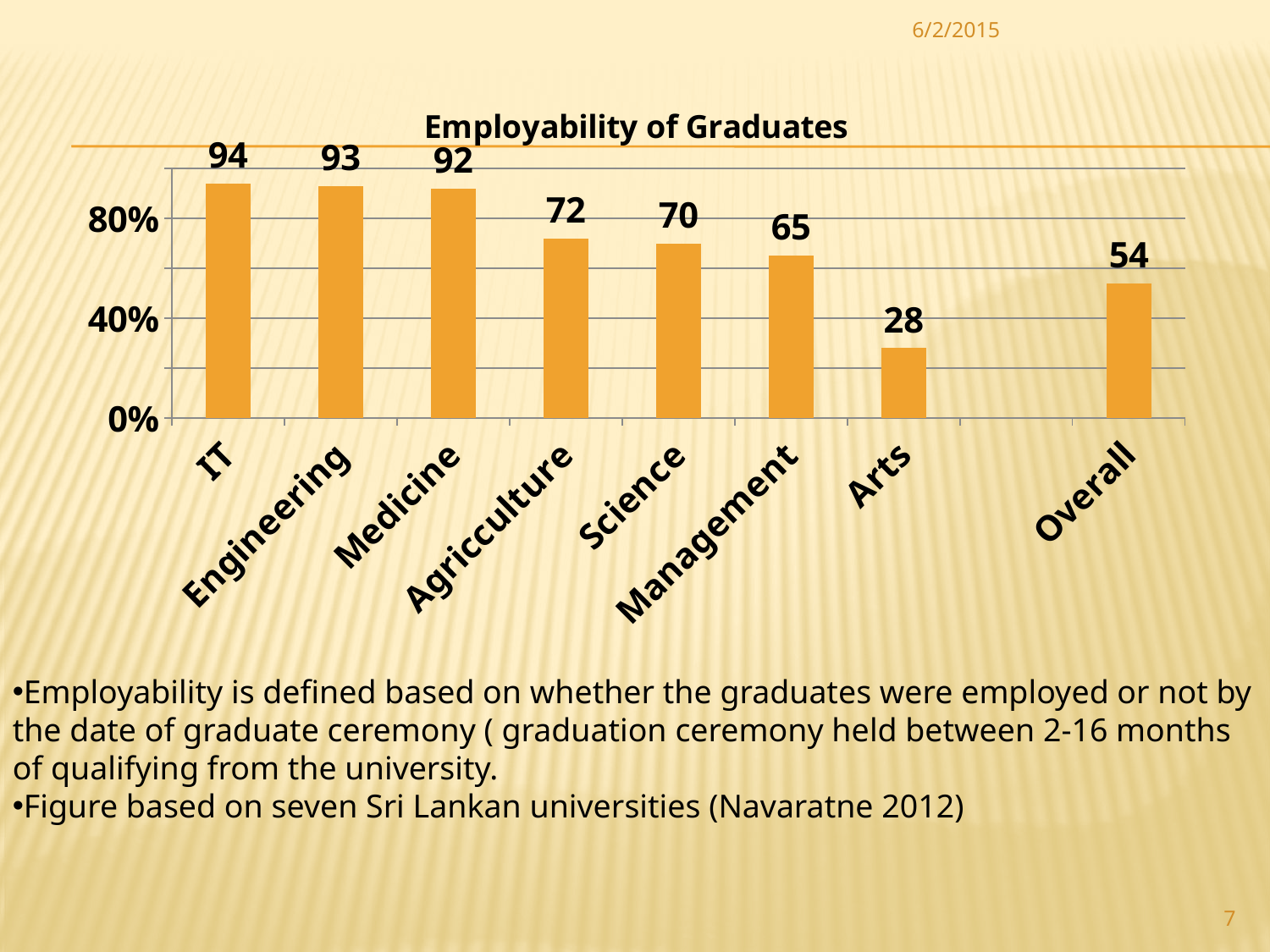
Which category has the lowest employability? Arts What is the title of the chart? Employability of Graduates Which is larger, the value for Science or the value for Overall? Science What is the difference between the values for IT and Arts? 66 What is the Overall employability value shown? 54 Is the value for Management greater or less than 40%? greater What is the difference between the values for Agricculture and Management? 7 Which category has the highest employability? IT What kind of chart is shown? bar chart What is the employability value for Medicine? 92 How many categories are shown on the x axis? 8 What is the employability value for Arts? 28